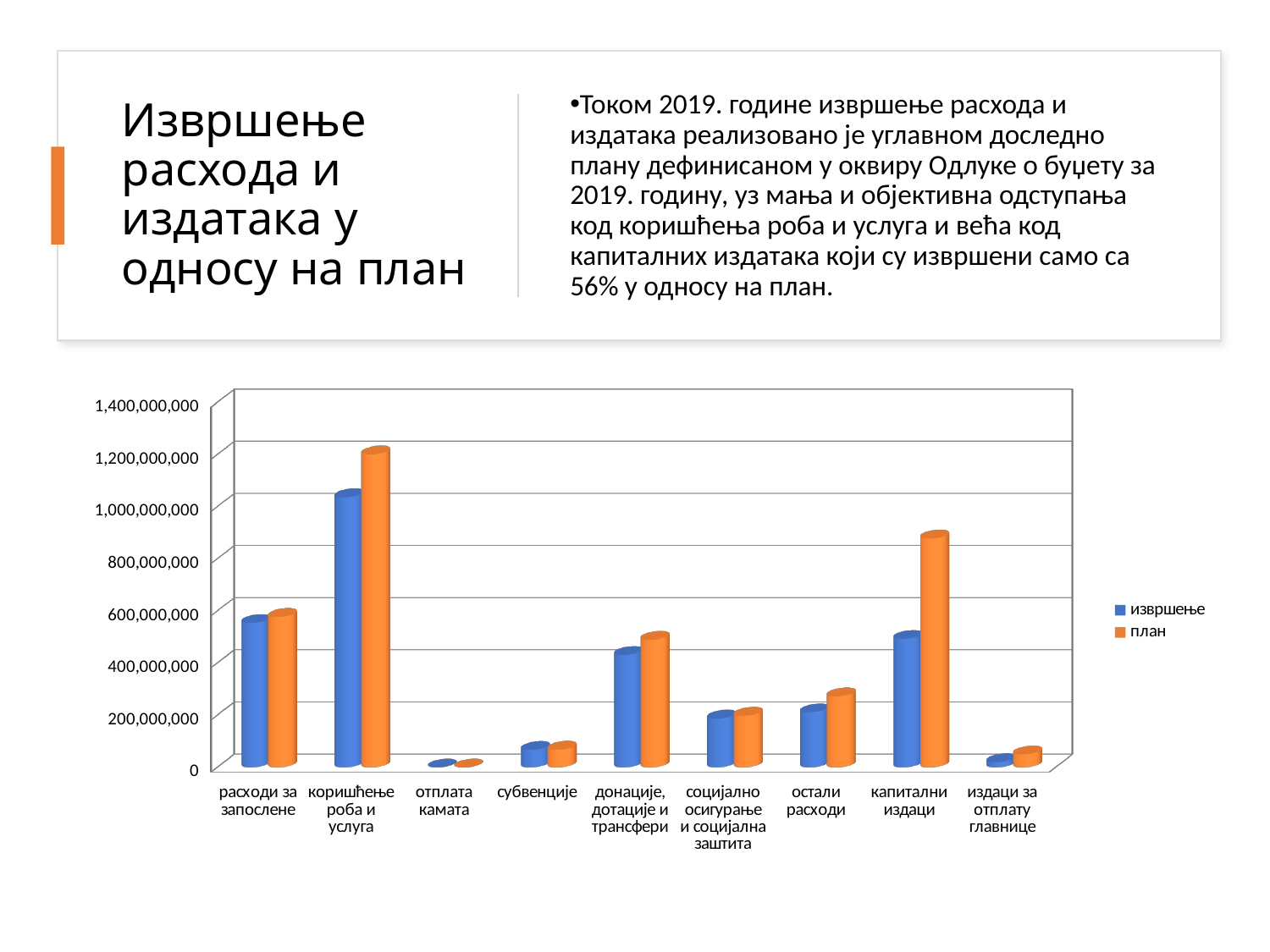
Which colour represents the план series in the chart? orange How many series does the chart legend list? 2 For остали расходи, which is larger: извршење or план? план Which category has the lowest извршење value? отплата камата Is the план value for донације, дотације и трансфери greater or less than 400,000,000? greater For капитални издаци, which is larger: извршење or план? план What kind of chart is shown on the slide? bar chart Which category has the highest план value? коришћење роба и услуга Is the план value for коришћење роба и услуга greater or less than 1,000,000,000? greater Is the извршење value for расходи за запослене greater or less than 600,000,000? less How many categories are shown on the x axis of the chart? 9